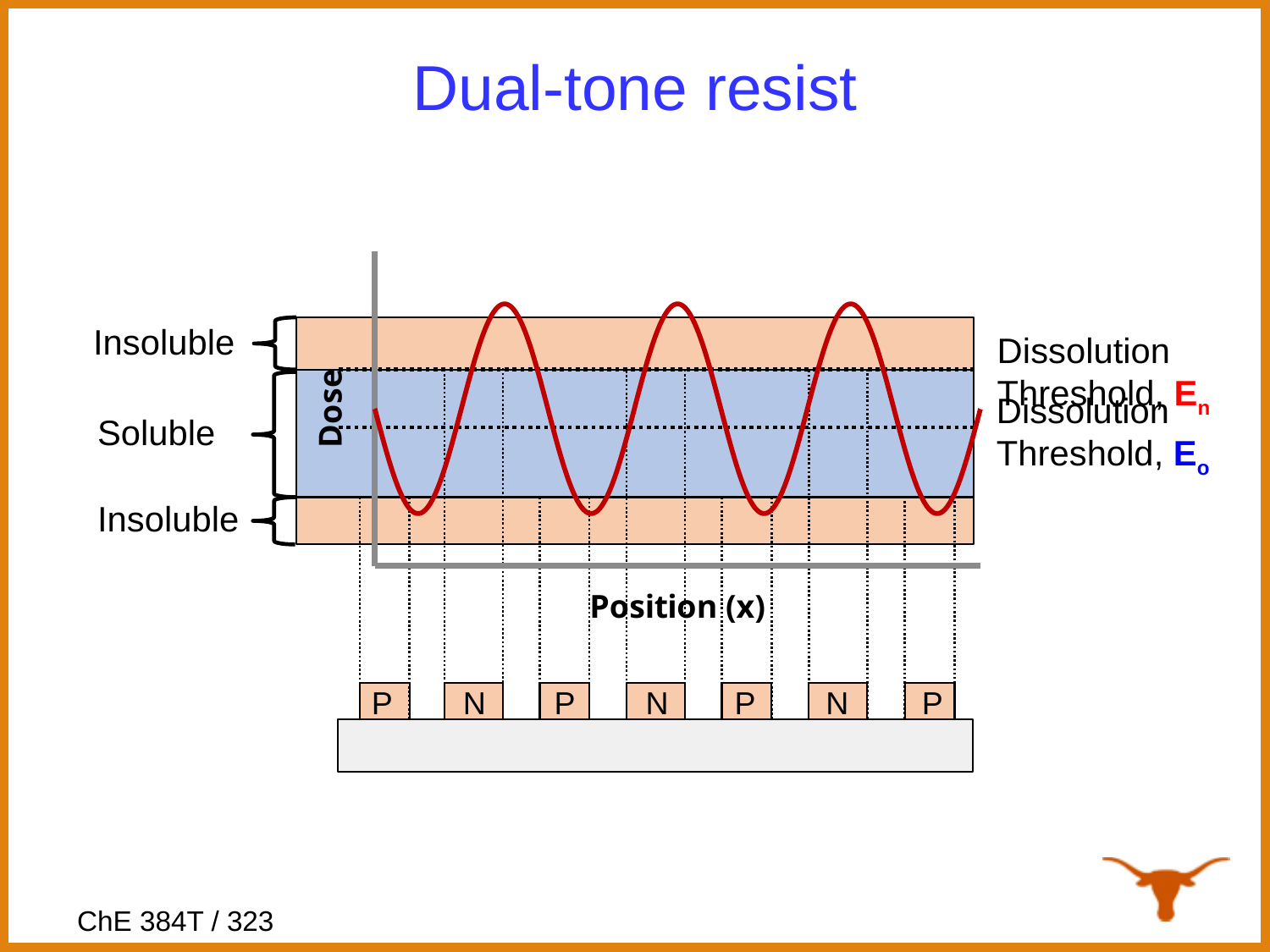
How many P and N blocks are drawn below the chart in total? 7 What kind of chart is shown on the slide? line chart How many troughs (minima) does the red dose curve have across the chart? 4 How many blocks labeled P are drawn below the chart? 4 What is the label of the vertical axis of the chart? Dose Does the red dose curve rise steadily, fall steadily, or oscillate along the position axis? oscillate What is the label of the horizontal axis of the chart? Position (x)